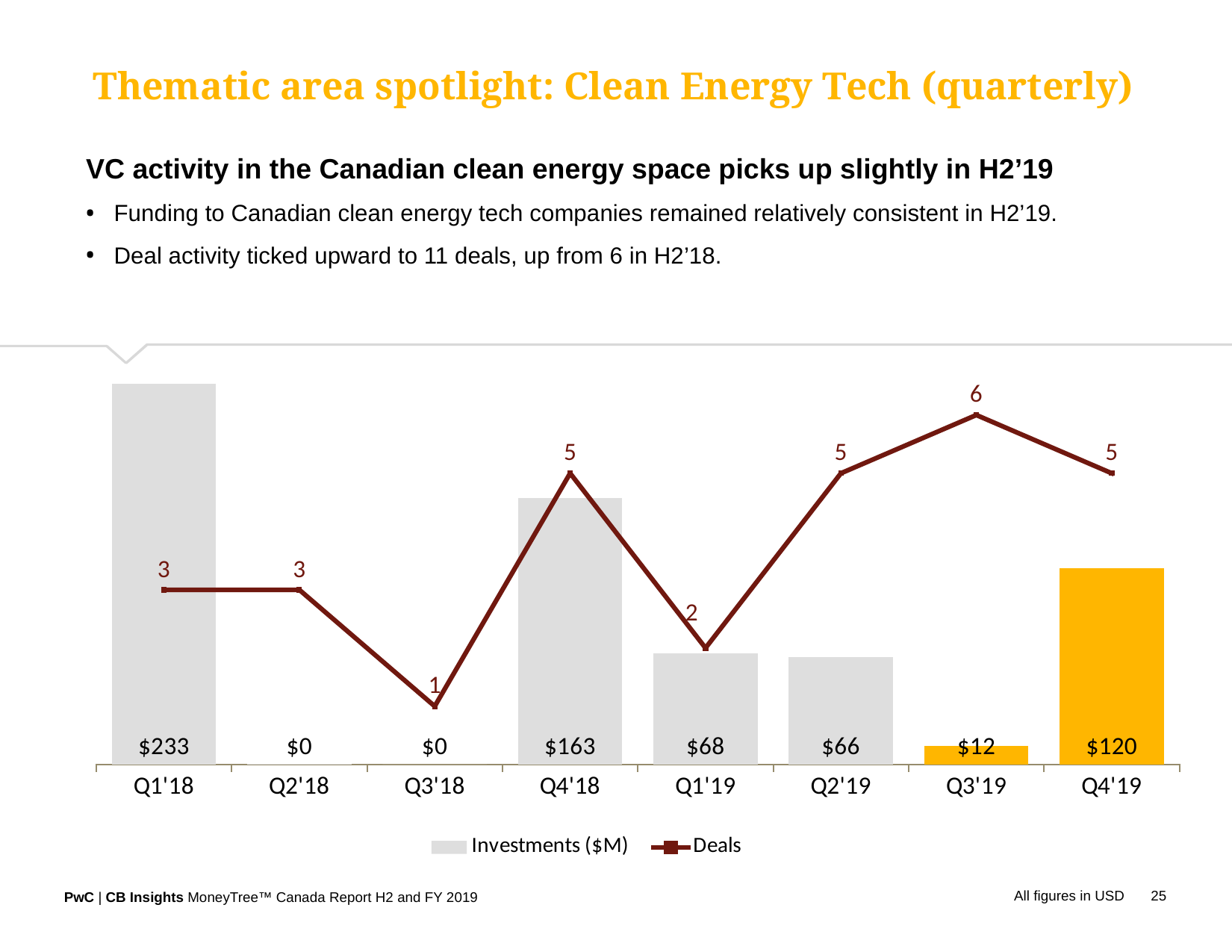
How many series does the legend list? 2 How many quarters are shown on the x axis? 8 What kind of chart is used to show Investments ($M)? Bar chart How many deals were recorded in Q3'19? 6 Which quarter has the highest Investments ($M) value? Q1'18 Do the deals rise or fall from Q1'19 to Q3'19? Rise What is the difference in Investments ($M) between Q4'18 and Q1'19? $95 Which quarter has more deals, Q1'19 or Q2'19? Q2'19 What are the two series listed in the legend? Investments ($M) and Deals Which quarter has the lowest number of deals? Q3'18 What is the Investments ($M) value for Q1'18? $233 What is the Investments ($M) value for Q4'19? $120